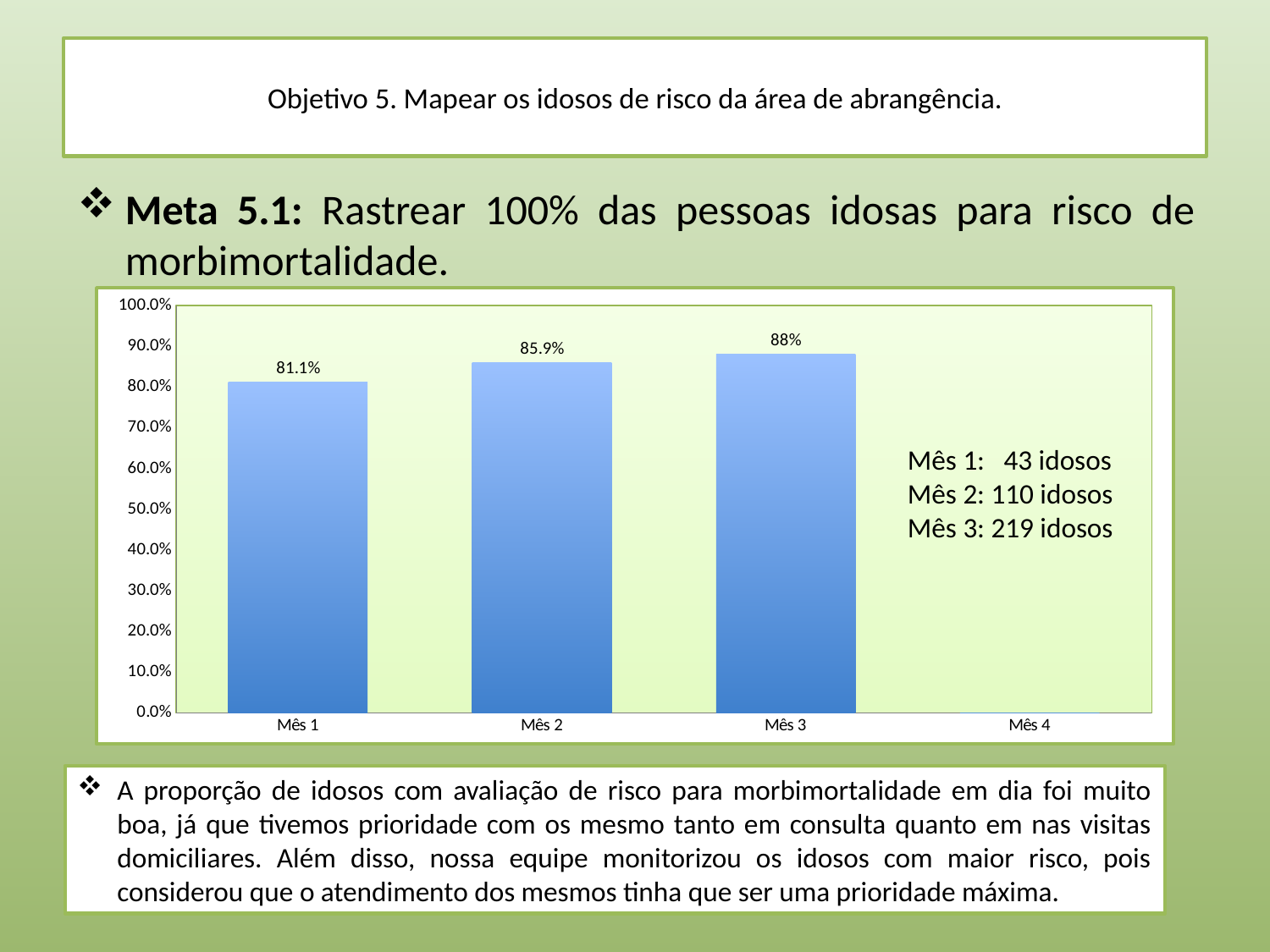
Is the value for Mês 1 greater or less than 90.0%? less What is the difference in percentage points between Mês 3 and Mês 1? 6.9 percentage points What kind of chart is shown on the slide? Bar chart What is the value shown for Mês 1? 81.1% What is the value shown for Mês 2? 85.9% How many month categories are shown on the x axis? 4 What is the value shown for Mês 3? 88% Which month has the highest value among the bars shown? Mês 3 Which month with a plotted bar has the lowest value? Mês 1 What is the difference in percentage points between Mês 2 and Mês 1? 4.8 percentage points Do the values rise or fall from Mês 1 to Mês 3? Rise Which is larger, the value for Mês 2 or the value for Mês 3? Mês 3